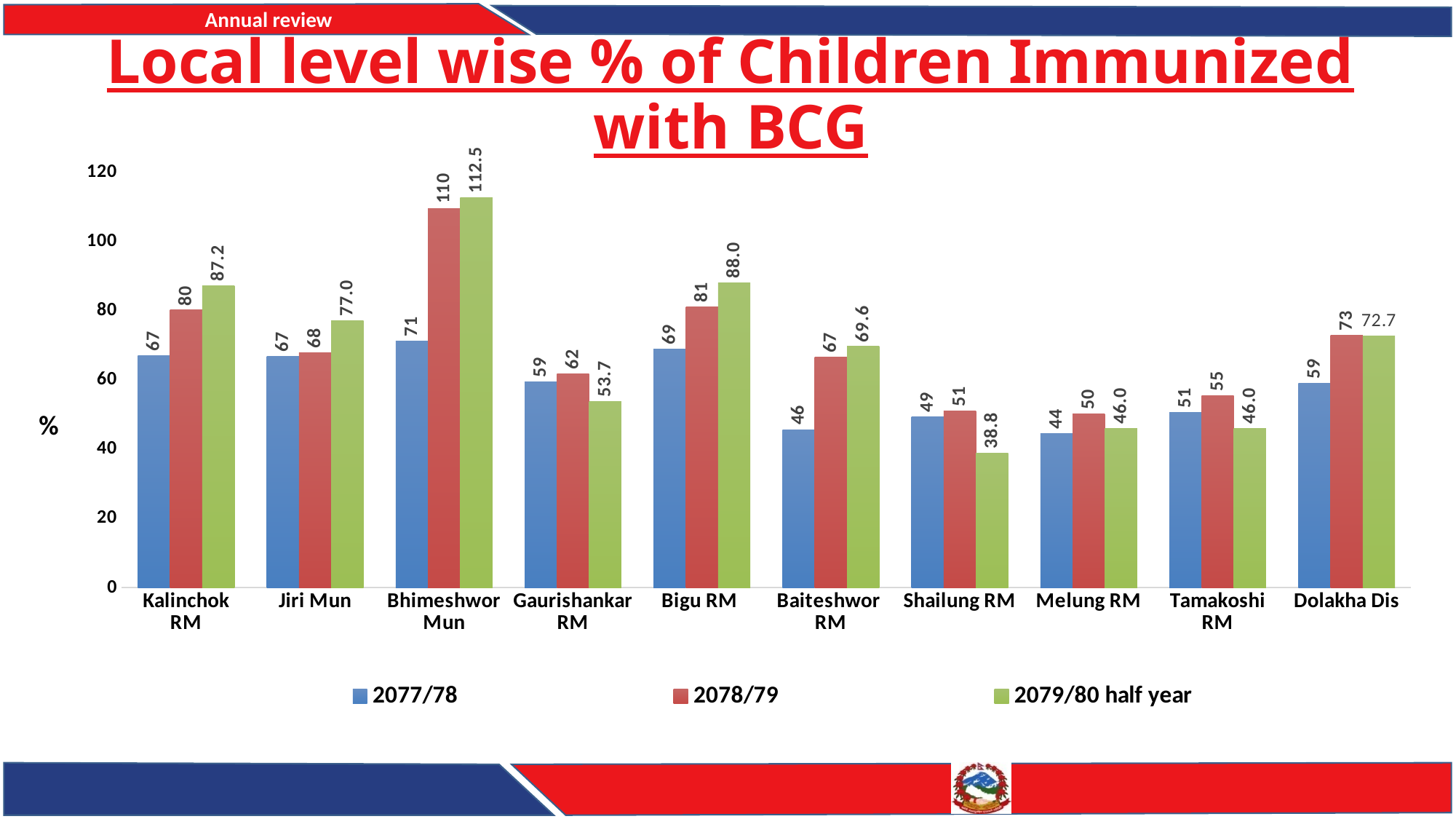
What kind of chart is shown on the slide? Bar chart What is the title of the chart? Local level wise % of Children Immunized with BCG What is the value for Shailung RM in the 2077/78 series? 49 What is the value for Dolakha Dis in the 2078/79 series? 73 What is the value for Bhimeshwor Mun in the 2079/80 half year series? 112.5 Which local level has the lowest value in the 2077/78 series? Melung RM Which local level has the lowest value in the 2079/80 half year series? Shailung RM Which local level has the highest value in the 2079/80 half year series? Bhimeshwor Mun How many local levels are shown on the x axis? 10 How many series does the legend list? 3 Which is larger for Gaurishankar RM: the 2078/79 value or the 2079/80 half year value? 2078/79 What is the difference between the 2079/80 half year value and the 2077/78 value for Kalinchok RM? 20.2